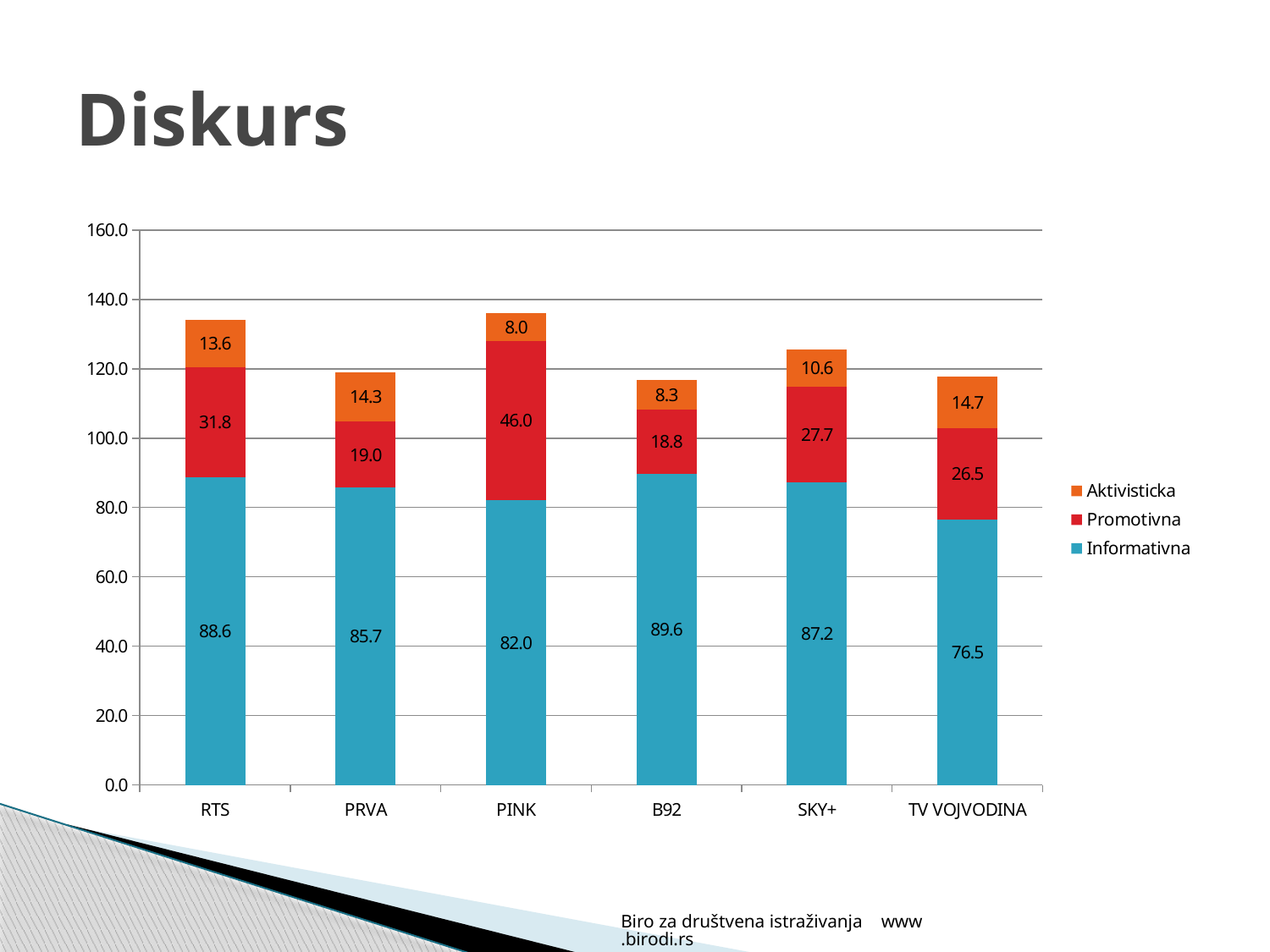
How many categories are shown on the x axis? 6 What is the difference between the Promotivna values for RTS and PRVA? 12.8 What is the total of the stacked bar for B92? 116.7 What is the Aktivisticka value for TV VOJVODINA? 14.7 What is the Informativna value for RTS? 88.6 What is the Promotivna value for PINK? 46.0 How many series does the legend list? 3 Which category has the lowest Informativna value? TV VOJVODINA Is the total of the stacked bar for PINK greater or less than 120.0? greater What kind of chart is shown on the slide? Stacked bar chart Which category has the highest Promotivna value? PINK Which is larger, the Aktivisticka value for PRVA or for SKY+? PRVA